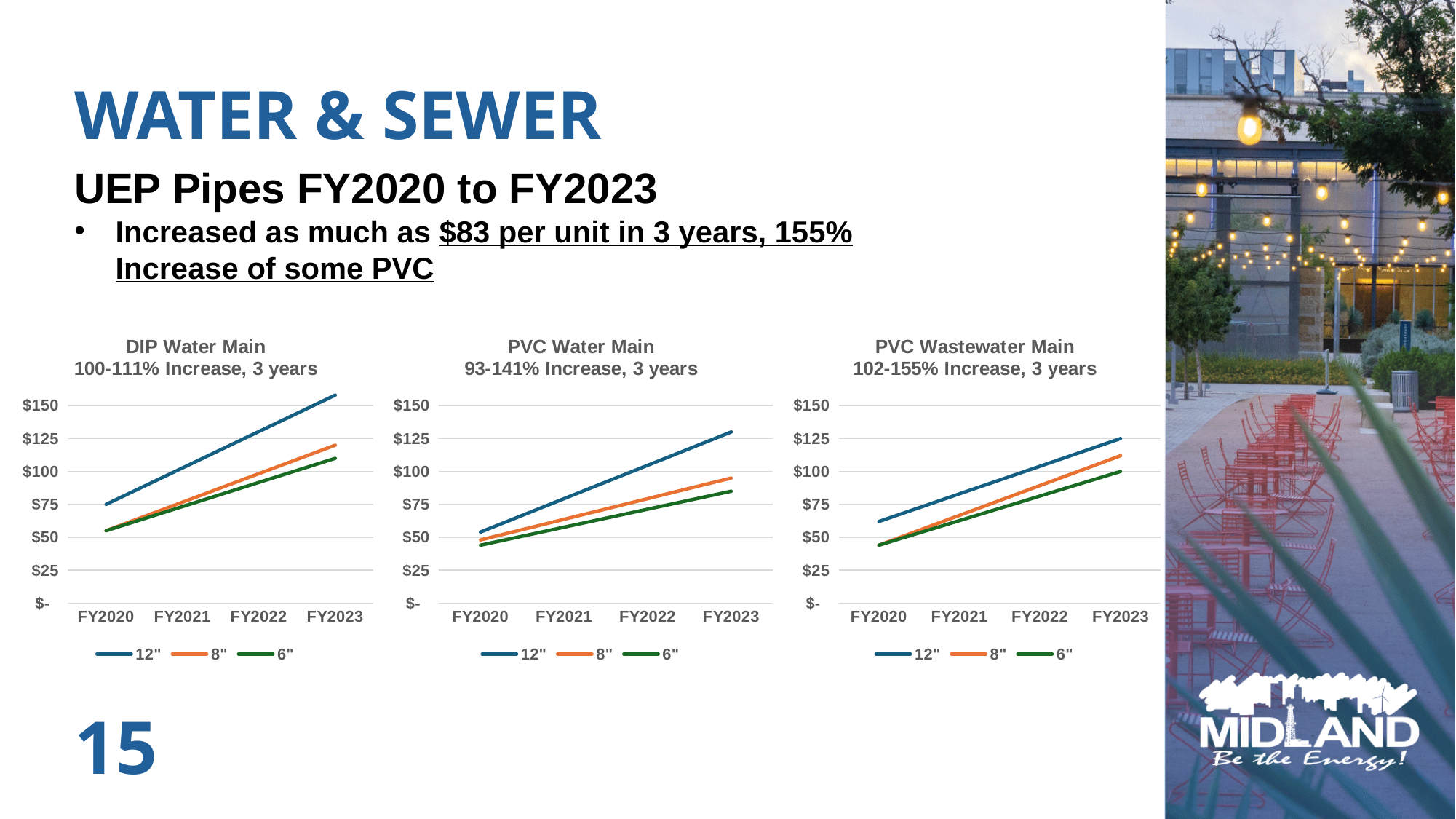
What kind of chart is the DIP Water Main chart? line chart In the DIP Water Main chart, which is larger in FY2023, the 12" value or the 6" value? 12" In the PVC Water Main chart, is the 6" value for FY2020 greater or less than $50? less What percentage increase range is stated in the title of the PVC Wastewater Main chart? 102-155% Increase, 3 years How many fiscal years are shown on the x axis of the PVC Wastewater Main chart? 4 In the DIP Water Main chart, is the 12" value for FY2023 greater or less than $150? greater In the DIP Water Main chart, do the values rise or fall from FY2020 to FY2023? rise In the PVC Wastewater Main chart, which pipe size has the lowest value in FY2023? 6" In the PVC Water Main chart, which pipe size has the highest value in FY2023? 12" In the PVC Wastewater Main chart, is the 6" value for FY2020 greater or less than $50? less How many series does the legend of the PVC Water Main chart list? 3